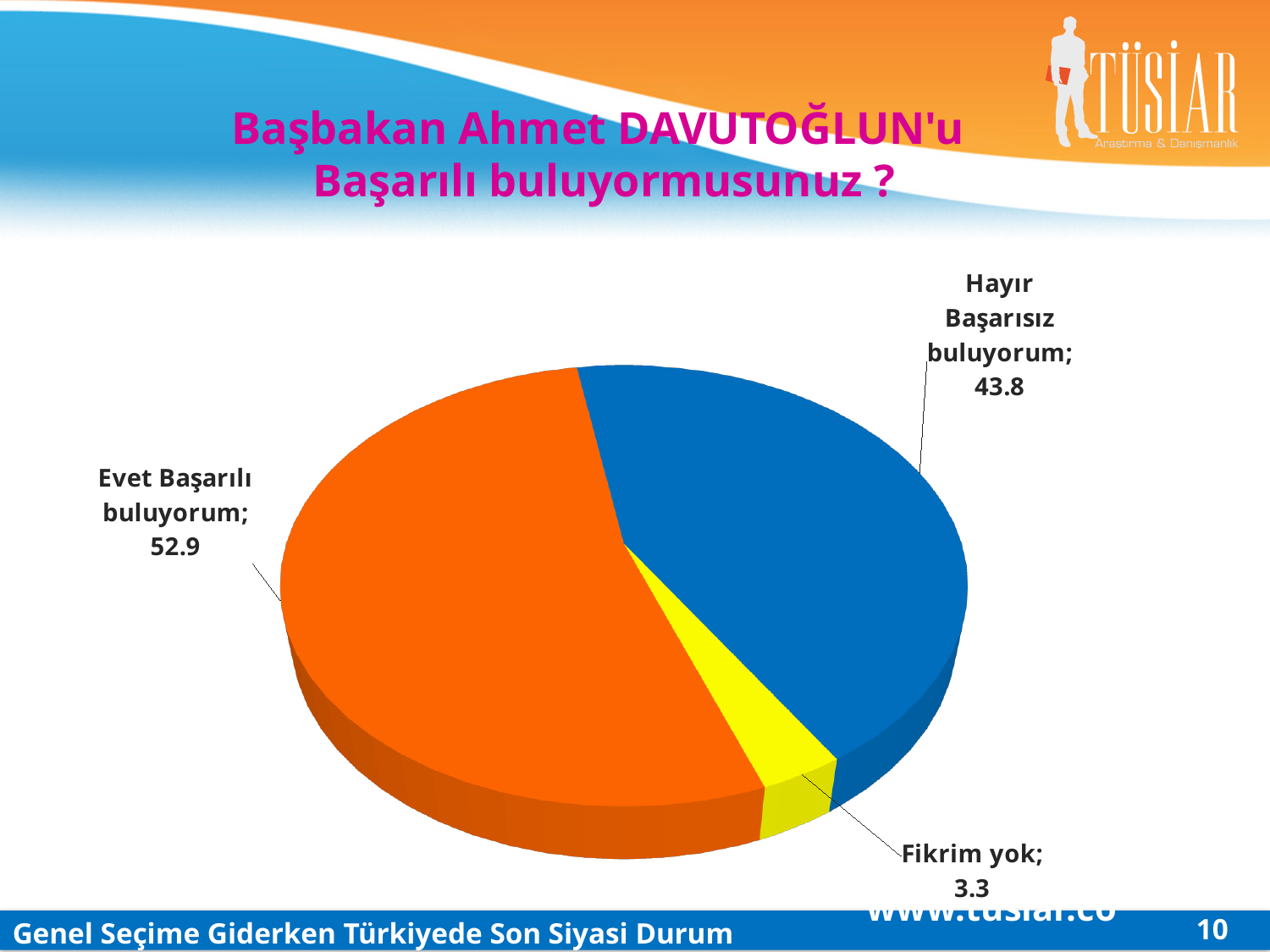
Which category has the largest slice of the pie? Evet Başarılı buluyorum Which category has the smallest slice of the pie? Fikrim yok What is the title of the chart on the slide? Başbakan Ahmet DAVUTOĞLUN'u Başarılı buluyormusunuz ? What is the difference between the values for "Evet Başarılı buluyorum" and "Hayır Başarısız buluyorum"? 9.1 Which is larger: the value for "Evet Başarılı buluyorum" or the value for "Hayır Başarısız buluyorum"? Evet Başarılı buluyorum How many categories (slices) does the pie chart have? 3 What value is shown for "Evet Başarılı buluyorum" in the pie chart? 52.9 What is the difference between the values for "Hayır Başarısız buluyorum" and "Fikrim yok"? 40.5 What value is shown for "Hayır Başarısız buluyorum" in the pie chart? 43.8 What colour is the slice for "Fikrim yok"? Yellow What kind of chart is shown on the slide? Pie chart What value is shown for "Fikrim yok" in the pie chart? 3.3